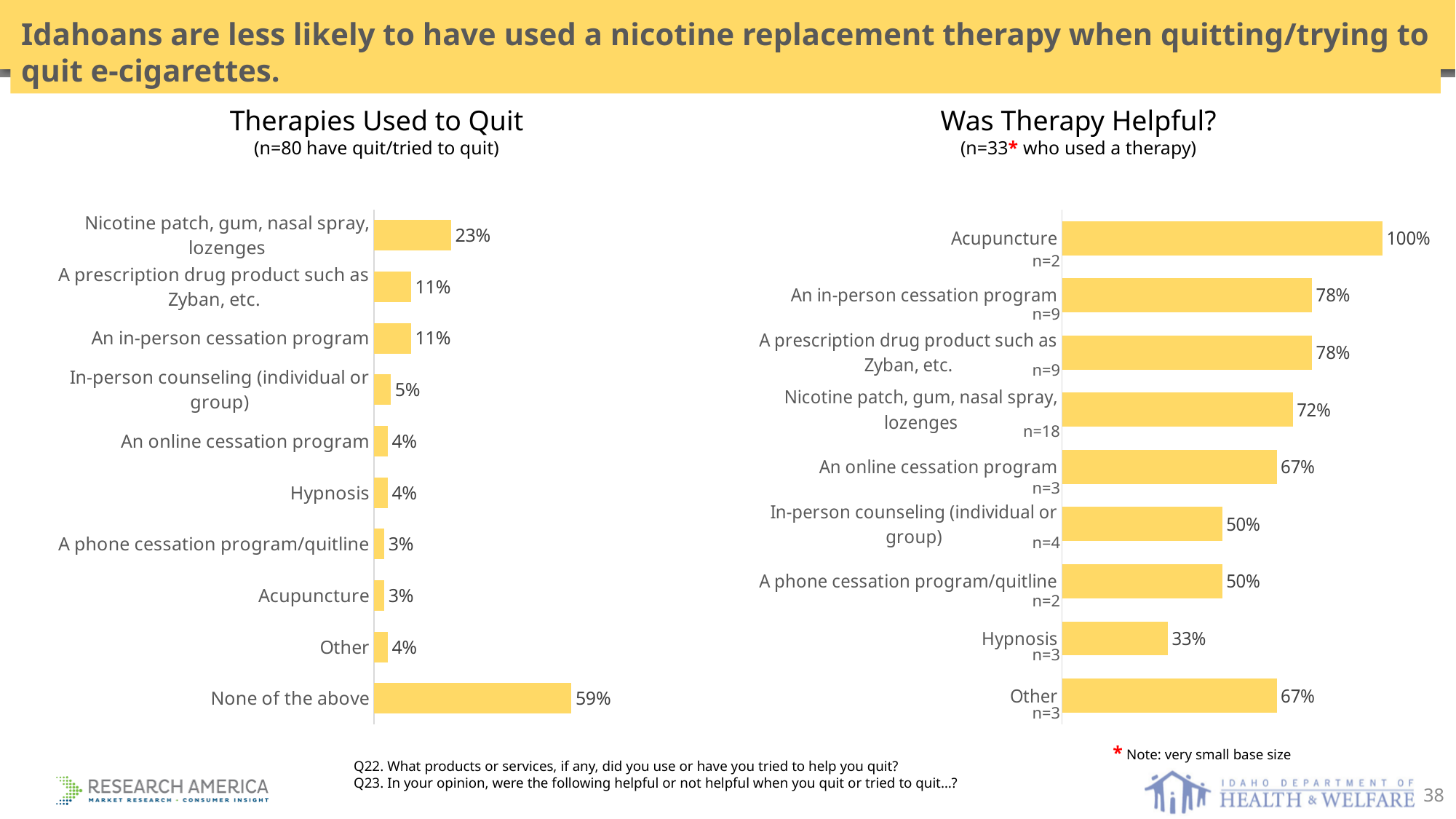
In the 'Was Therapy Helpful?' chart, which therapy has the lowest value? Hypnosis In the 'Therapies Used to Quit' chart, what is the difference between 'None of the above' and 'Nicotine patch, gum, nasal spray, lozenges'? 36 percentage points In the 'Therapies Used to Quit' chart, how many categories are shown? 10 In the 'Therapies Used to Quit' chart, what percentage selected 'None of the above'? 59% In the 'Was Therapy Helpful?' chart, what is the difference between 'An in-person cessation program' and 'Nicotine patch, gum, nasal spray, lozenges'? 6 percentage points In the 'Therapies Used to Quit' chart, what percentage used a nicotine patch, gum, nasal spray, or lozenges? 23% In the 'Was Therapy Helpful?' chart, what percentage found hypnosis helpful? 33% In the 'Was Therapy Helpful?' chart, which is larger: the value for 'An online cessation program' or for 'In-person counseling (individual or group)'? An online cessation program In the 'Was Therapy Helpful?' chart, what percentage found acupuncture helpful? 100% In the 'Was Therapy Helpful?' chart, what is the base size (n) shown for 'Nicotine patch, gum, nasal spray, lozenges'? n=18 In the 'Therapies Used to Quit' chart, which category has the highest value? None of the above What type of chart is 'Was Therapy Helpful?'? Bar chart